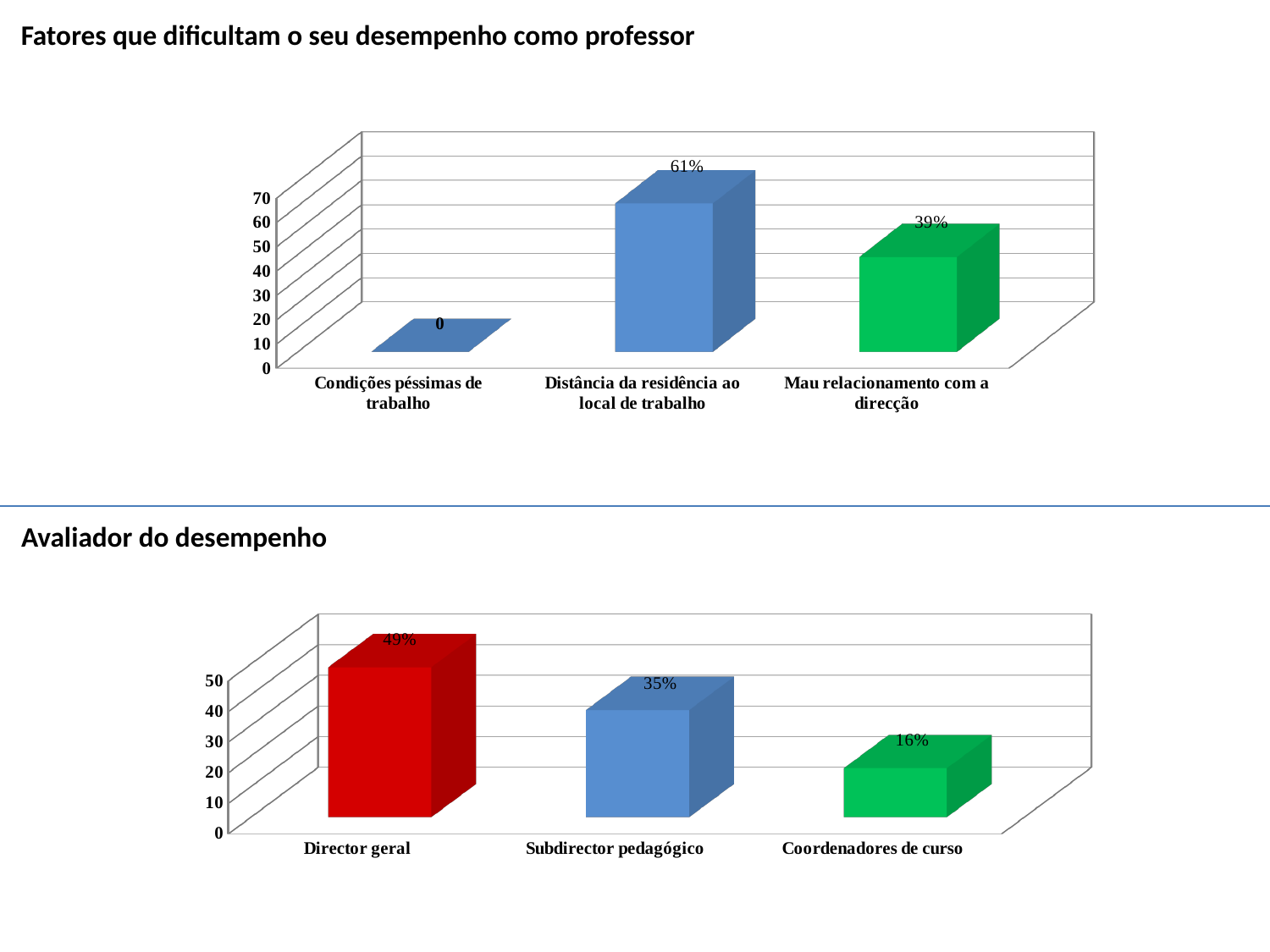
In the 'Fatores que dificultam o seu desempenho como professor' chart, which category has the highest value? Distância da residência ao local de trabalho In the 'Avaliador do desempenho' chart, what is the value for 'Director geral'? 49% In the 'Fatores que dificultam o seu desempenho como professor' chart, what is the difference between 'Distância da residência ao local de trabalho' and 'Mau relacionamento com a direcção'? 22% In the 'Fatores que dificultam o seu desempenho como professor' chart, what is the value for 'Distância da residência ao local de trabalho'? 61% In the 'Avaliador do desempenho' chart, what is the difference between 'Director geral' and 'Coordenadores de curso'? 33% In the 'Fatores que dificultam o seu desempenho como professor' chart, what is the value for 'Mau relacionamento com a direcção'? 39% In the 'Fatores que dificultam o seu desempenho como professor' chart, how many categories are shown? 3 What kind of chart is the 'Avaliador do desempenho' chart? Bar chart In the 'Avaliador do desempenho' chart, which is larger, 'Subdirector pedagógico' or 'Coordenadores de curso'? Subdirector pedagógico In the 'Fatores que dificultam o seu desempenho como professor' chart, what is the value for 'Condições péssimas de trabalho'? 0 In the 'Avaliador do desempenho' chart, what is the value for 'Subdirector pedagógico'? 35% In the 'Avaliador do desempenho' chart, which category has the lowest value? Coordenadores de curso